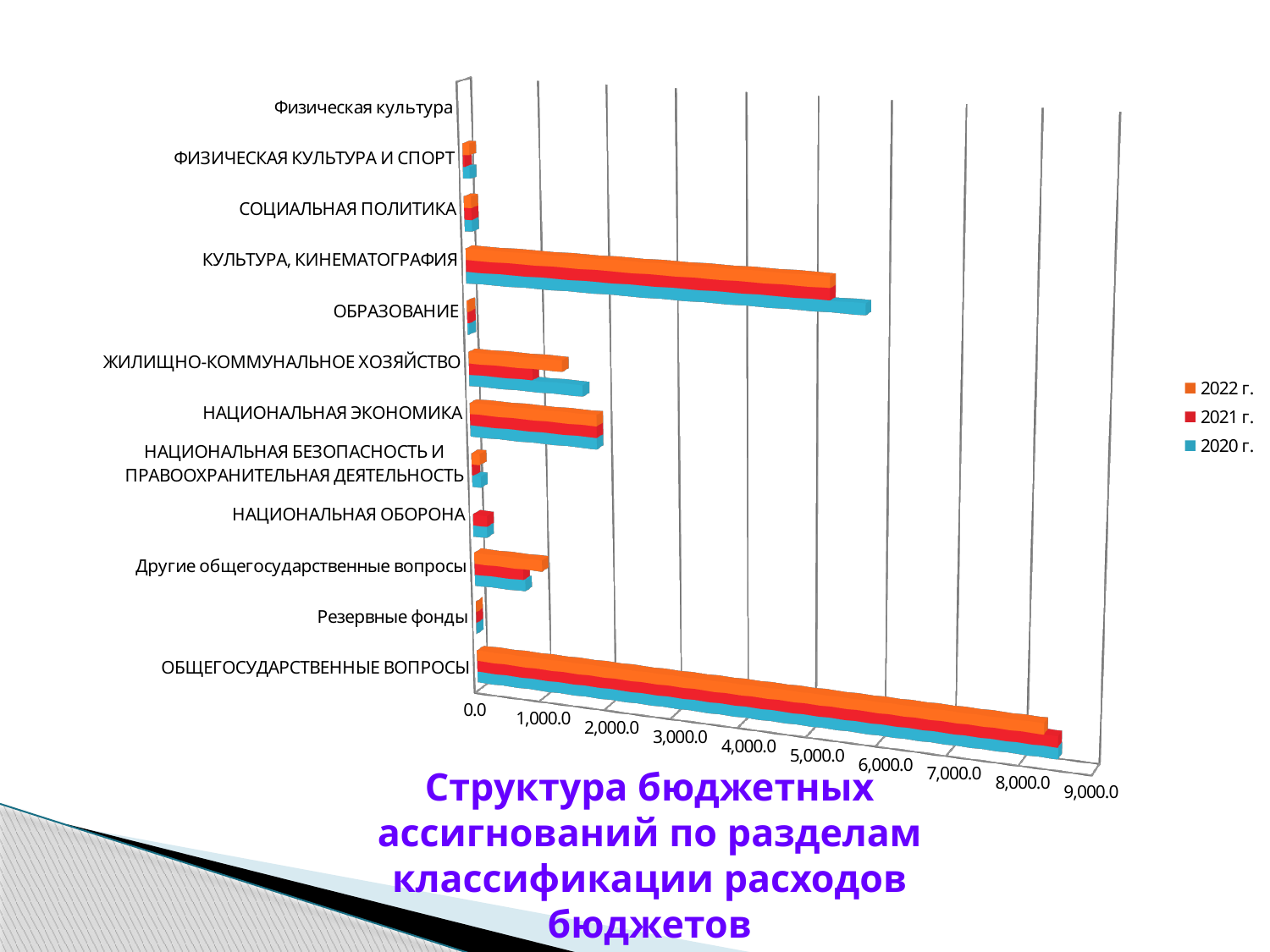
For КУЛЬТУРА, КИНЕМАТОГРАФИЯ, which is larger: the 2020 г. value or the 2022 г. value? 2020 г. What kind of chart is shown on the slide? Bar chart Is the 2022 г. value for ОБЩЕГОСУДАРСТВЕННЫЕ ВОПРОСЫ greater or less than 5,000.0? greater Is the 2022 г. value for НАЦИОНАЛЬНАЯ ЭКОНОМИКА greater or less than 3,000.0? less Which category has the highest values in the chart? ОБЩЕГОСУДАРСТВЕННЫЕ ВОПРОСЫ How many categories are shown on the vertical axis of the chart? 12 For ЖИЛИЩНО-КОММУНАЛЬНОЕ ХОЗЯЙСТВО, which is larger: the 2020 г. value or the 2021 г. value? 2020 г. Is the 2022 г. value for ЖИЛИЩНО-КОММУНАЛЬНОЕ ХОЗЯЙСТВО greater or less than 2,000.0? less Which years are listed in the chart legend? 2022 г., 2021 г., 2020 г. In 2022 г., which category has the larger value: КУЛЬТУРА, КИНЕМАТОГРАФИЯ or НАЦИОНАЛЬНАЯ ЭКОНОМИКА? КУЛЬТУРА, КИНЕМАТОГРАФИЯ How many series does the legend list? 3